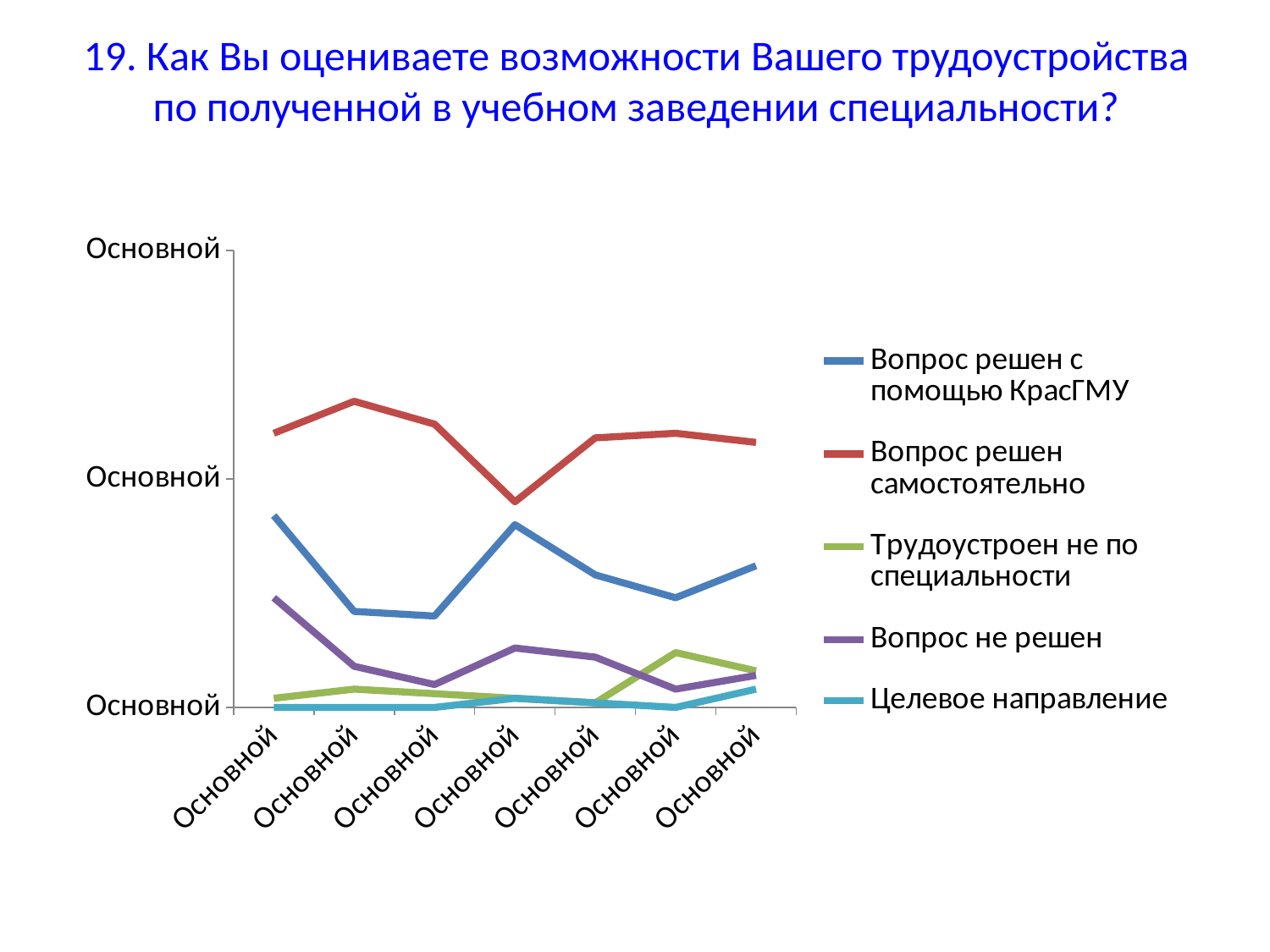
Which series has the lowest value at the first point on the x axis? Целевое направление What kind of chart is shown on the slide? line chart Does the line for Вопрос решен с помощью КрасГМУ rise or fall between the first and second points on the x axis? fall Which series is drawn in red? Вопрос решен самостоятельно Which series is plotted second highest across the chart? Вопрос решен с помощью КрасГМУ At the sixth point on the x axis, which is larger: Трудоустроен не по специальности or Вопрос не решен? Трудоустроен не по специальности Does the line for Вопрос решен самостоятельно rise or fall between the third and fourth points on the x axis? fall How many series does the legend list? 5 At the first point on the x axis, which is larger: Вопрос не решен or Трудоустроен не по специальности? Вопрос не решен Which series has the highest values across the whole chart? Вопрос решен самостоятельно Which series is drawn in green? Трудоустроен не по специальности How many points are plotted along the x axis for each series? 7